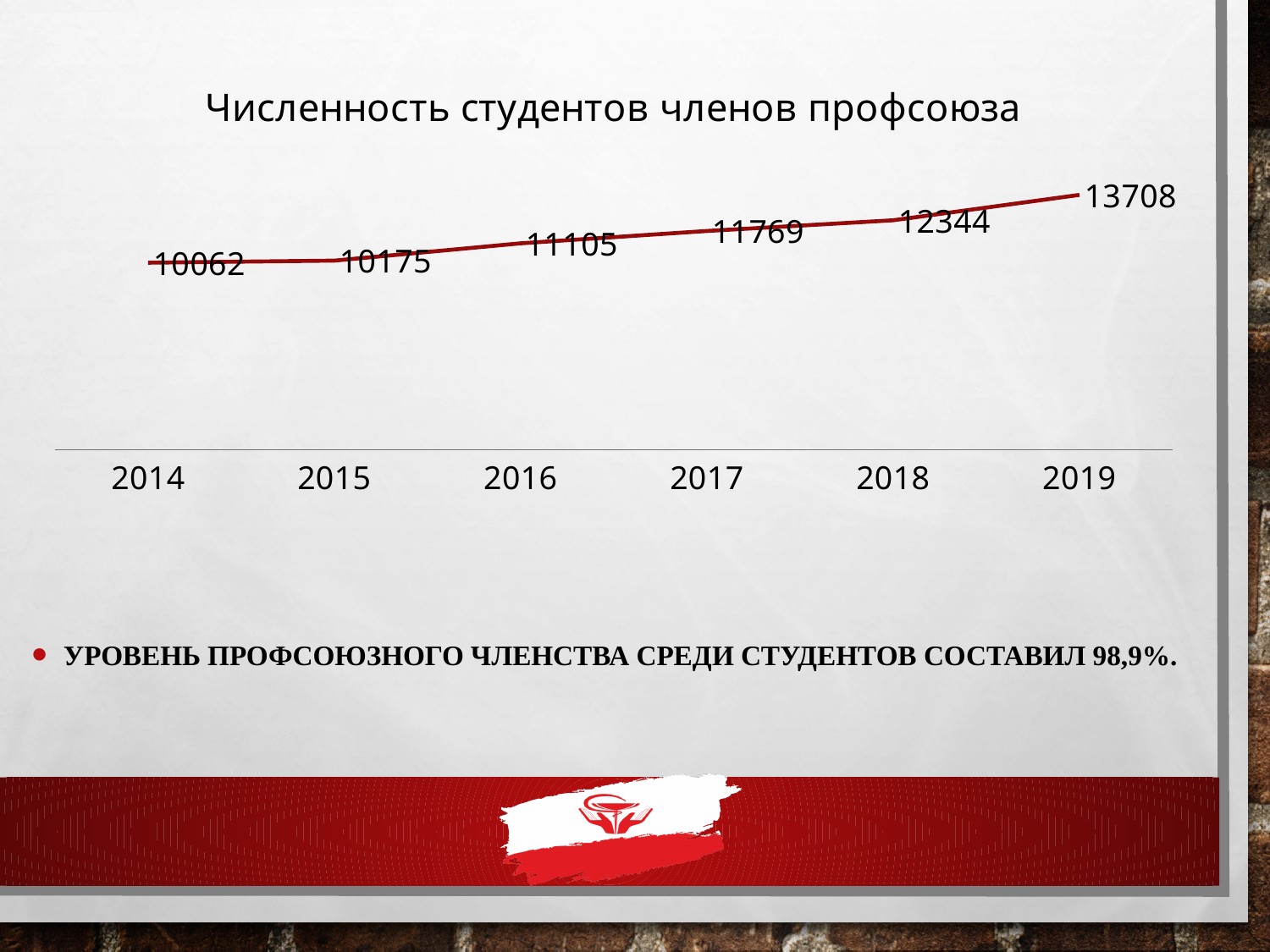
What is the difference between the values for 2018 and 2017? 575 Which is larger, the value for 2016 or the value for 2015? 2016 What is the title of the chart? Численность студентов членов профсоюза What is the value for 2019? 13708 Which year has the lowest value? 2014 How many years are shown on the x axis? 6 Do the values rise or fall from 2014 to 2019? rise What kind of chart is this? line chart What is the difference between the values for 2019 and 2014? 3646 Which year has the highest value? 2019 What is the value for 2017? 11769 What is the value for 2014? 10062